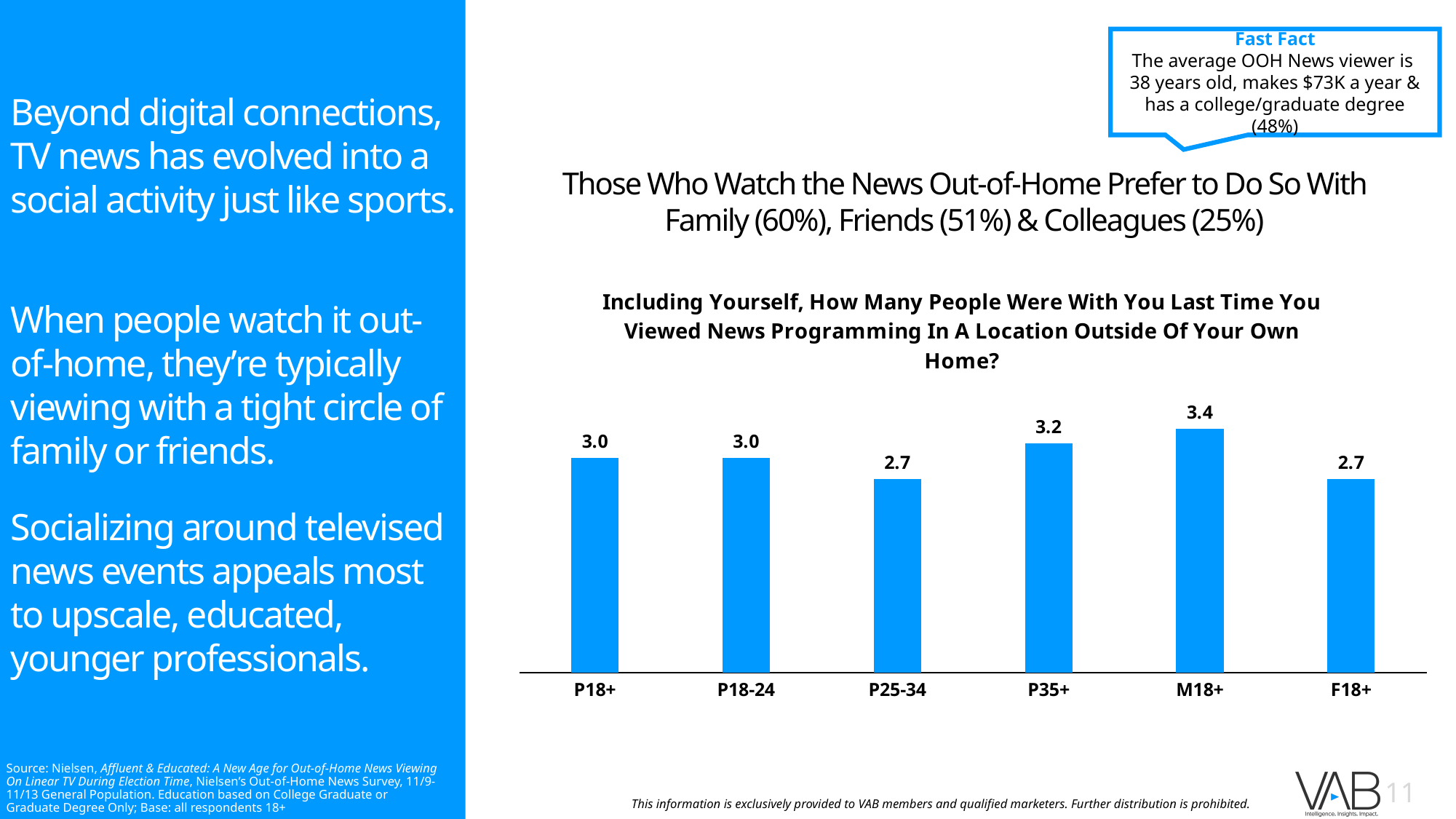
Which two categories share the lowest value of 2.7? P25-34 and F18+ What kind of chart is shown on the slide? Bar chart What colour are the bars in the chart? Blue What is the difference between the values for M18+ and F18+? 0.7 What is the value for P35+? 3.2 What is the value for P25-34? 2.7 What is the value for P18+? 3.0 What is the difference between the values for P35+ and P25-34? 0.5 Which category has the highest value? M18+ Which is larger, the value for P35+ or the value for P18-24? P35+ What is the value for M18+? 3.4 How many categories are shown on the x axis of the chart? 6